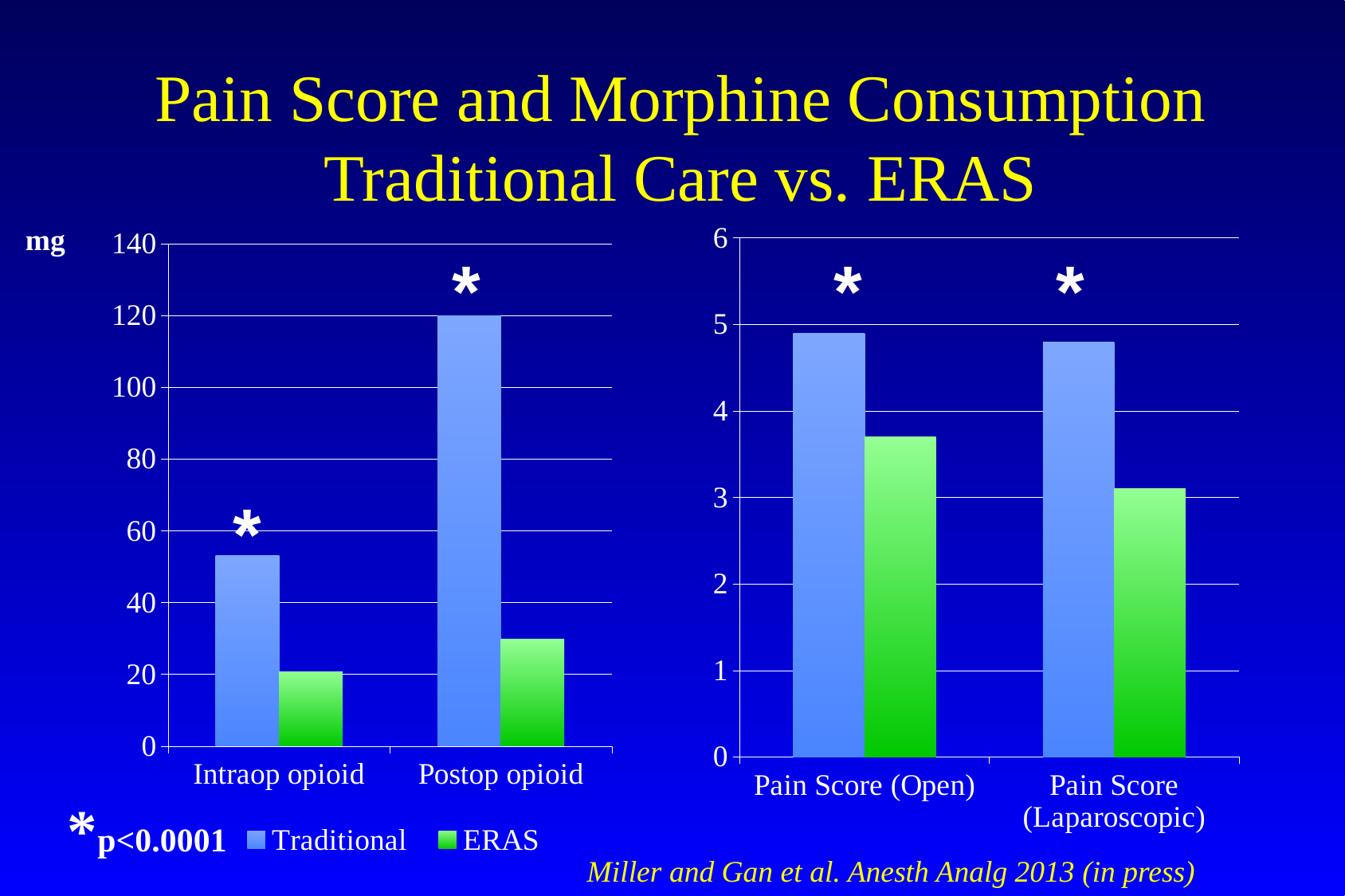
In the right chart, is the Traditional value for Pain Score (Laparoscopic) greater or less than 4? greater In the left chart, is the ERAS value for Intraop opioid greater or less than 40? less In the left chart, which series has the higher value for Postop opioid, Traditional or ERAS? Traditional How many series does the legend list? 2 What unit is shown on the y axis of the left chart? mg In the right chart, is the ERAS value for Pain Score (Open) greater or less than 4? less In the left chart, which bar is the tallest overall? Traditional, Postop opioid What kind of chart is the left chart showing opioid consumption? bar chart How many categories are shown on the x axis of the right chart (pain scores)? 2 In the right chart, which category has the lowest ERAS bar? Pain Score (Laparoscopic)